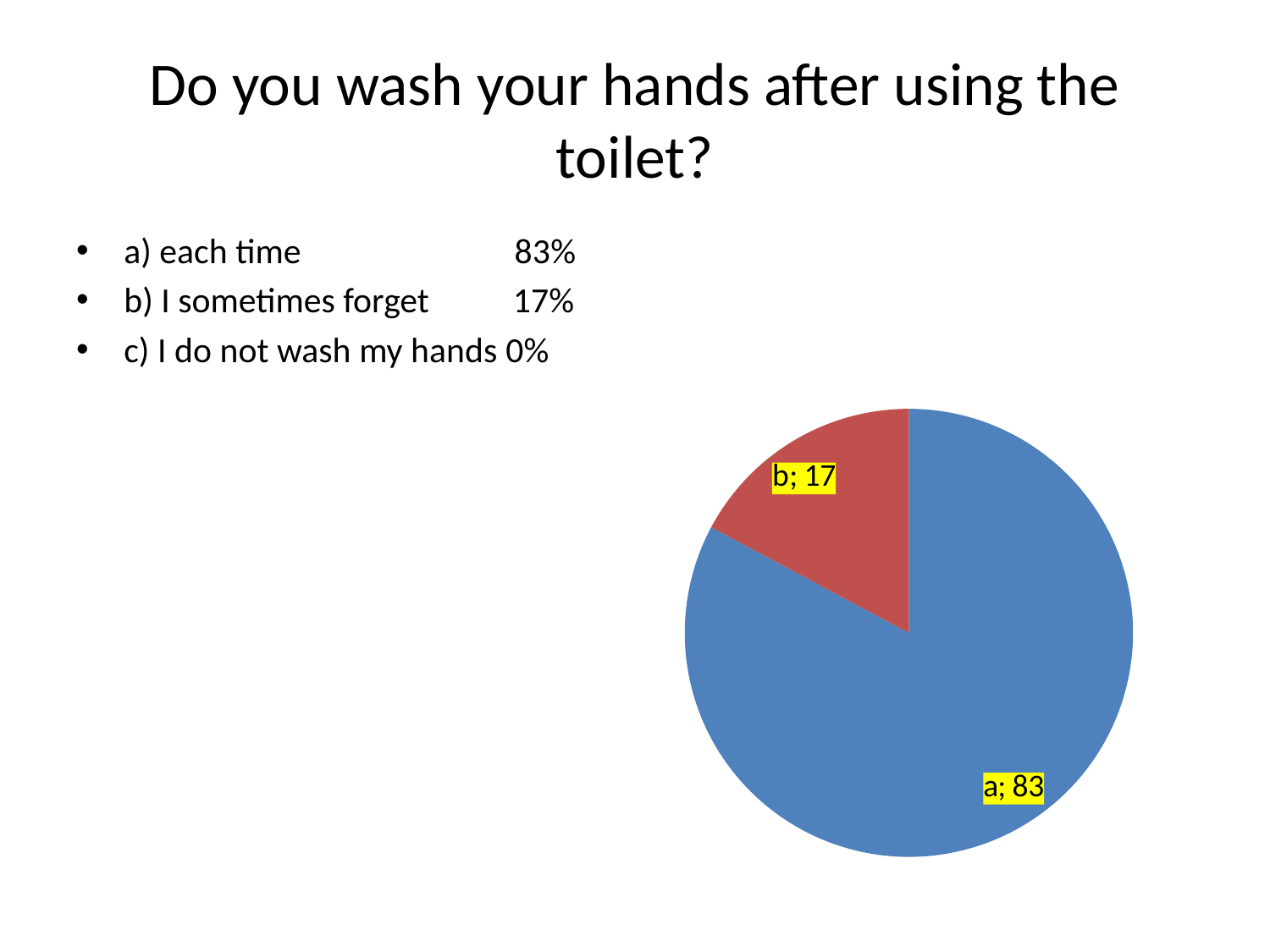
What is the value shown for slice a in the pie chart? 83 Which slice of the pie chart is the smallest? b What kind of chart is shown on the slide? pie chart What colour is slice b in the pie chart? red What colour is slice a in the pie chart? blue Which is larger, the value for slice a or slice b? a What share of the pie does slice b represent? 17% What is the difference between the values for slice a and slice b? 66 Which slice of the pie chart is the largest? a What is the value shown for slice b in the pie chart? 17 How many slices are visible in the pie chart? 2 What share of the pie does slice a represent? 83%